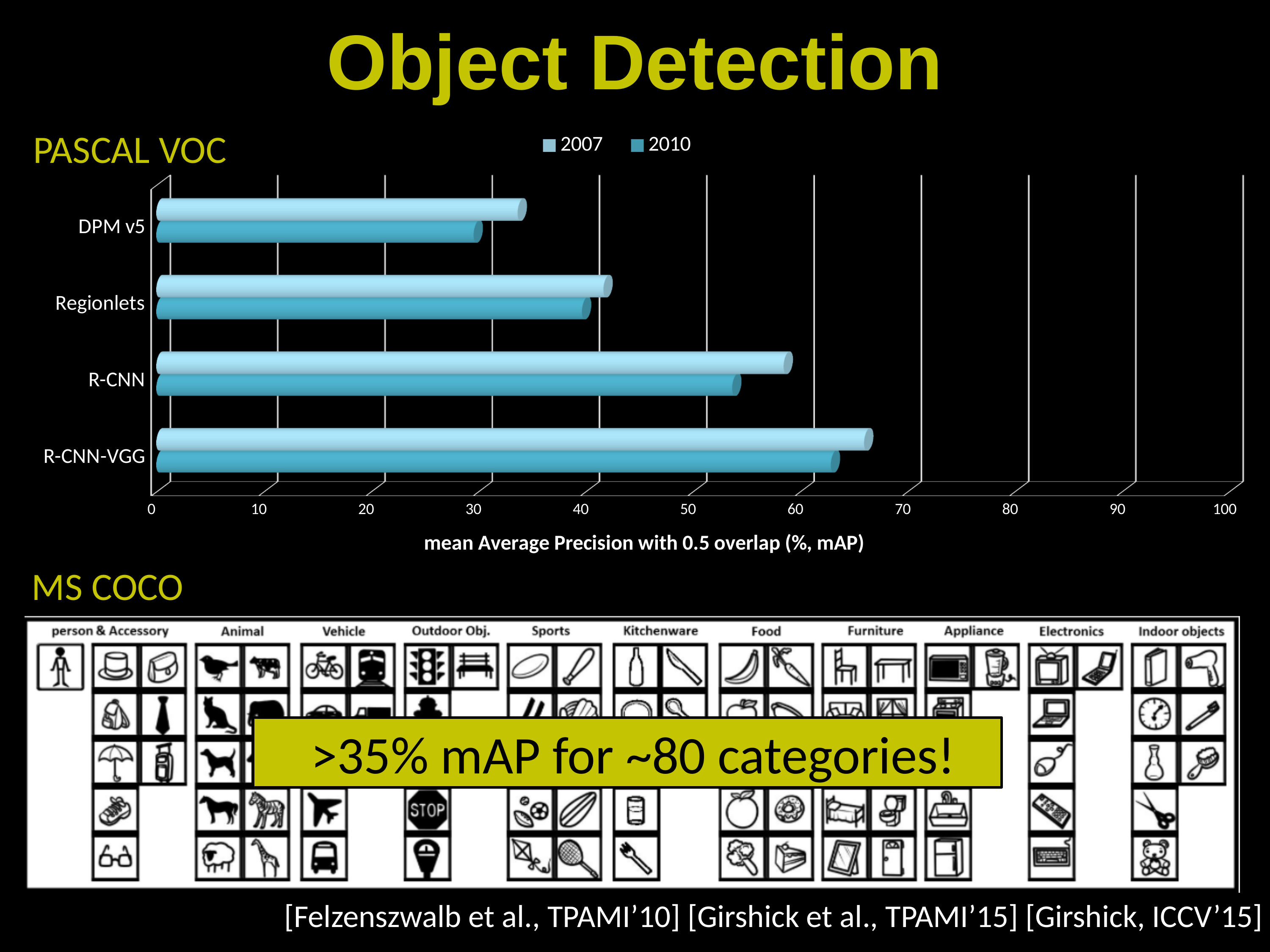
How many detection methods are plotted in the PASCAL VOC chart? 4 In the PASCAL VOC chart, which method has the lowest 2010 mAP? DPM v5 In the PASCAL VOC chart, is the 2007 value for R-CNN-VGG greater or less than 60? greater In the PASCAL VOC chart, which has the larger 2010 mAP for DPM v5: the 2007 bar or the 2010 bar? 2007 In the PASCAL VOC chart, which method has the highest 2007 mAP? R-CNN-VGG In the PASCAL VOC chart, is the 2010 value for R-CNN greater or less than 50? greater In the PASCAL VOC chart, is the 2010 value for Regionlets greater or less than 50? less What kind of chart is shown under the PASCAL VOC heading? bar chart In the PASCAL VOC chart, which has the larger 2007 mAP: R-CNN or Regionlets? R-CNN How many series does the legend of the PASCAL VOC chart list? 2 What is the x-axis title of the PASCAL VOC chart? mean Average Precision with 0.5 overlap (%, mAP)